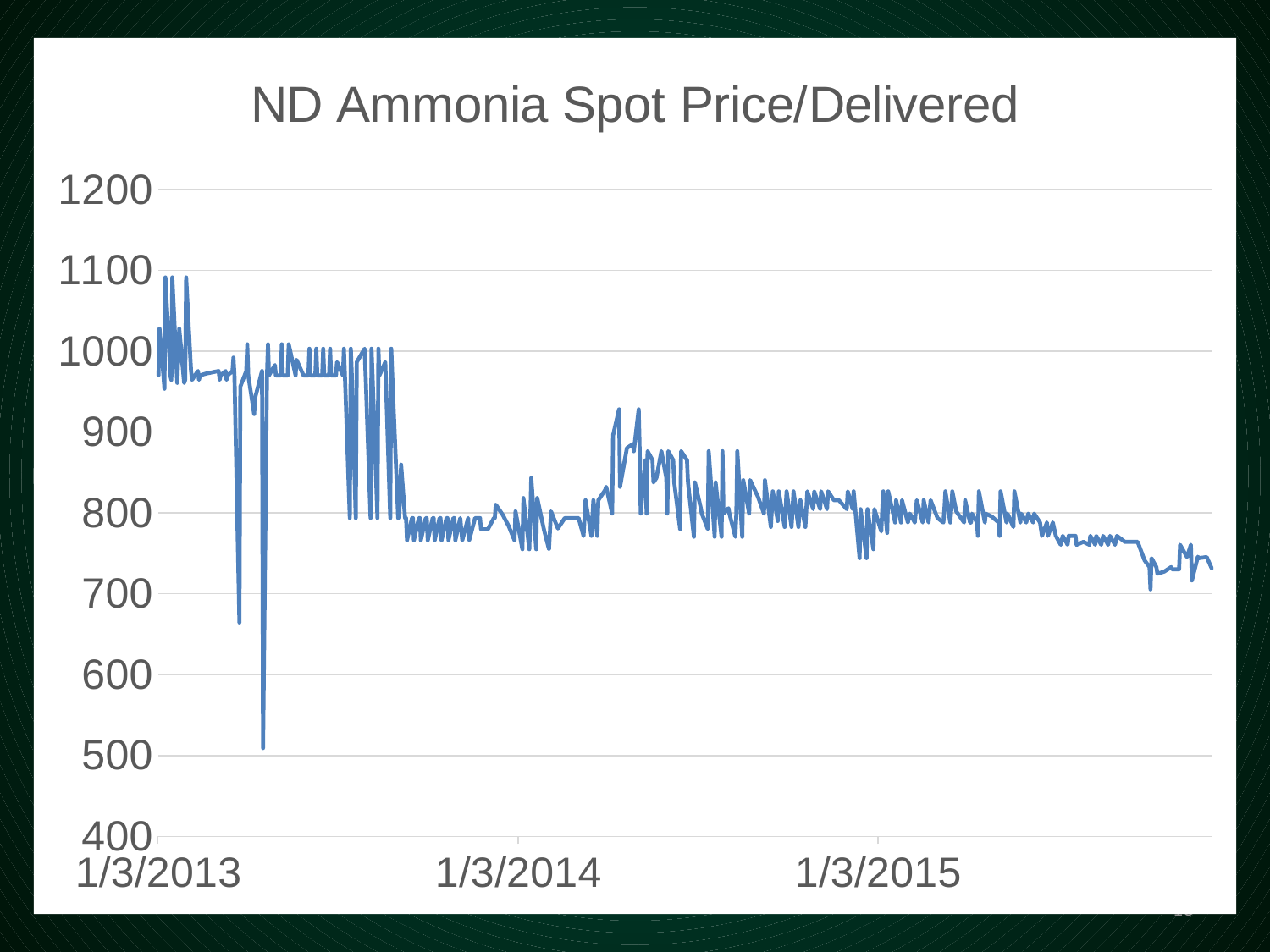
Which is larger, the value at 1/3/2013 or the value at 1/3/2015? 1/3/2013 What kind of chart is shown on the slide? line chart How many date labels are shown on the x axis? 3 Overall, do the values rise or fall from 1/3/2013 to the end of the chart? fall Is the highest point on the line greater or less than 1000? greater What is the title of the chart? ND Ammonia Spot Price/Delivered Is the lowest point on the line greater or less than 600? less Is the value at 1/3/2015 greater or less than 700? greater What is the highest value shown on the y axis? 1200